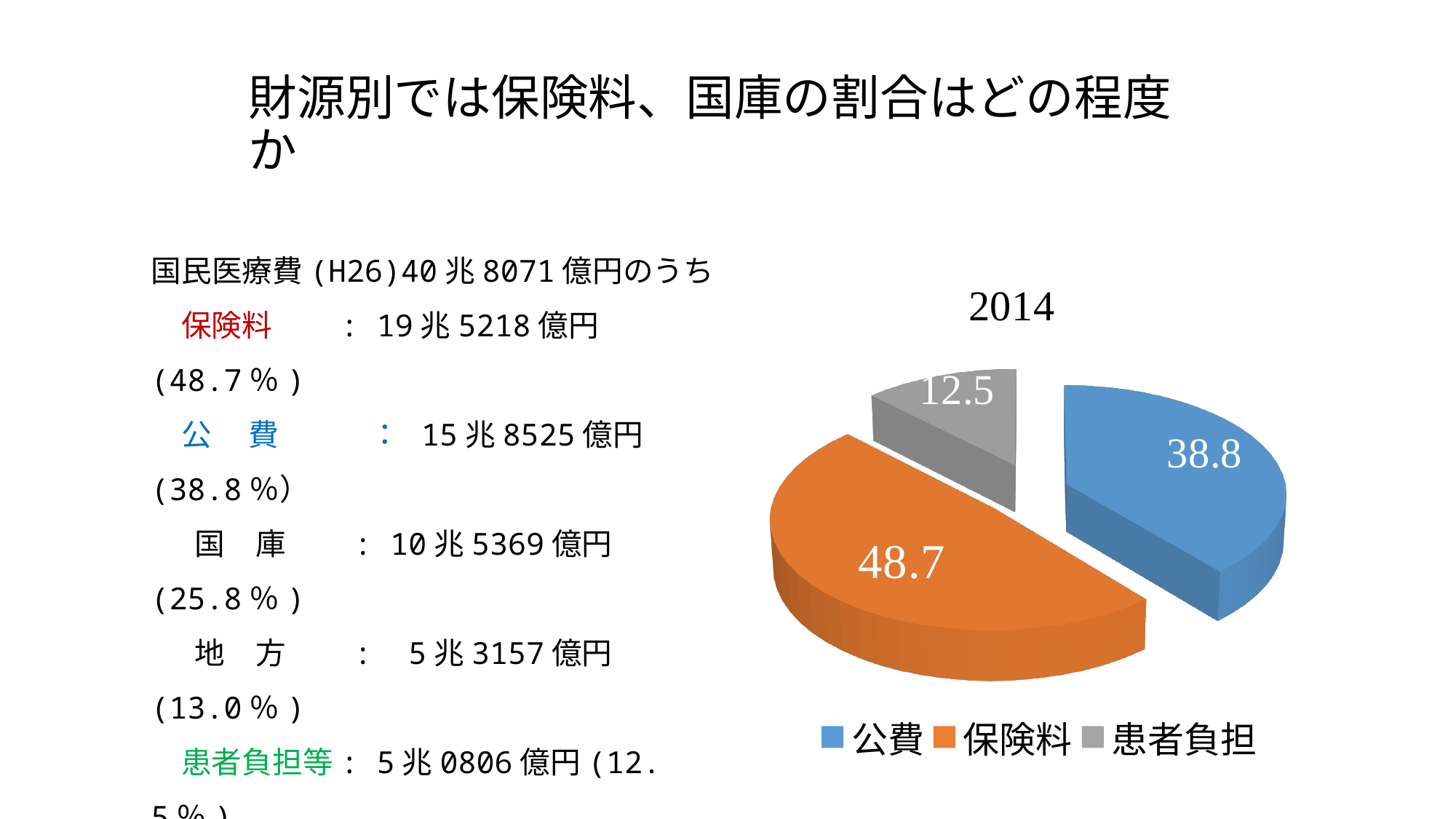
What value is shown for 保険料 in the pie chart? 48.7 What type of chart is shown on the slide? pie chart What value is shown for 公費 in the pie chart? 38.8 What is the difference between the values for 保険料 and 公費? 9.9 What colour is the 保険料 slice in the pie chart? orange Which category has the largest slice in the pie chart? 保険料 What value is shown for 患者負担 in the pie chart? 12.5 Which is larger, the value for 公費 or the value for 患者負担? 公費 Which category has the smallest slice in the pie chart? 患者負担 How many slices does the pie chart have? 3 What is the title of the chart? 2014 How many entries does the legend list? 3